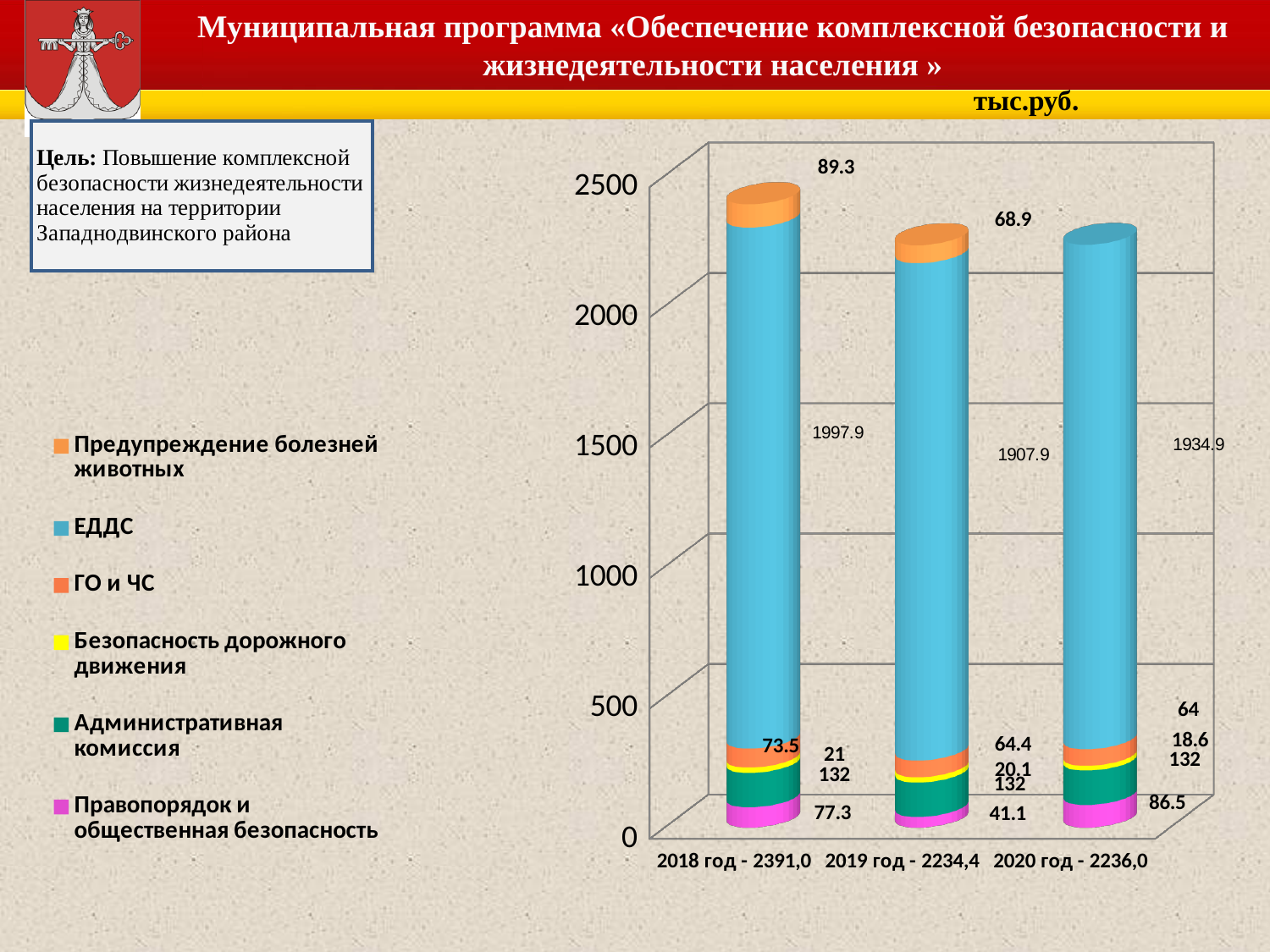
What kind of chart is shown on the slide? Stacked bar chart Which year has the larger value for Правопорядок и общественная безопасность, 2018 or 2020? 2020 What is the value for ГО и ЧС in 2019? 64.4 How many series does the legend list? 6 What is the value for Правопорядок и общественная безопасность in 2019? 41.1 What is the total of the stacked bar for 2018? 2391,0 In which year is the Правопорядок и общественная безопасность value lowest? 2019 What is the value for ЕДДС in 2018? 1997.9 How many years (bars) are shown on the chart? 3 What is the value for Безопасность дорожного движения in 2020? 18.6 What is the difference between the ЕДДС values for 2018 and 2019? 90 In which year is the ЕДДС value highest? 2018